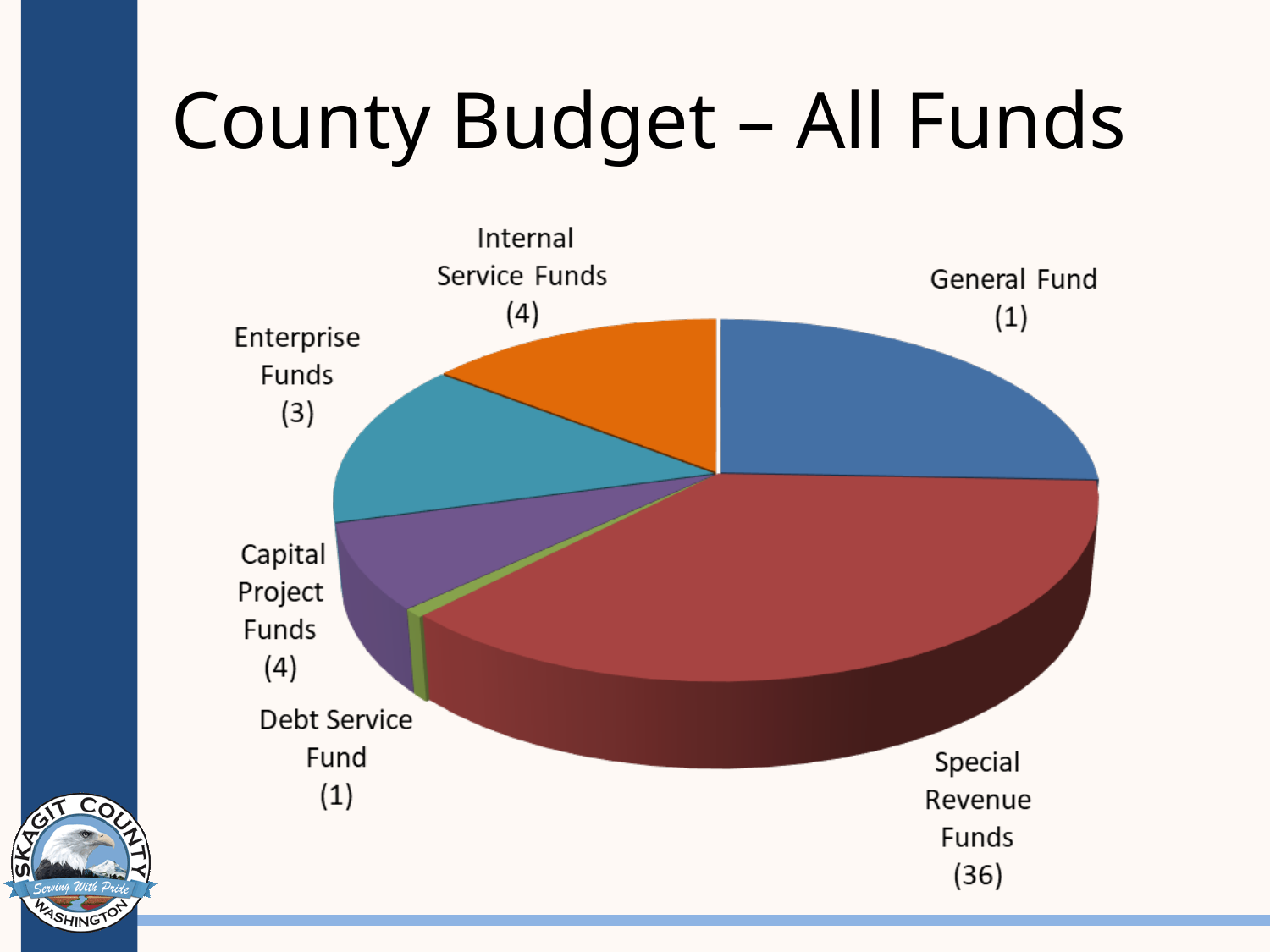
Which slice is larger, Special Revenue Funds or General Fund? Special Revenue Funds Which category has the smallest slice of the pie? Debt Service Fund Which slice is larger, Enterprise Funds or Capital Project Funds? Enterprise Funds How many slices does the pie chart have? 6 What kind of chart is shown on the slide? Pie chart What is the title of the chart on the slide? County Budget – All Funds What number appears in parentheses under the Special Revenue Funds label? 36 Which slice is larger, Debt Service Fund or Capital Project Funds? Capital Project Funds Which category has the largest slice of the pie? Special Revenue Funds